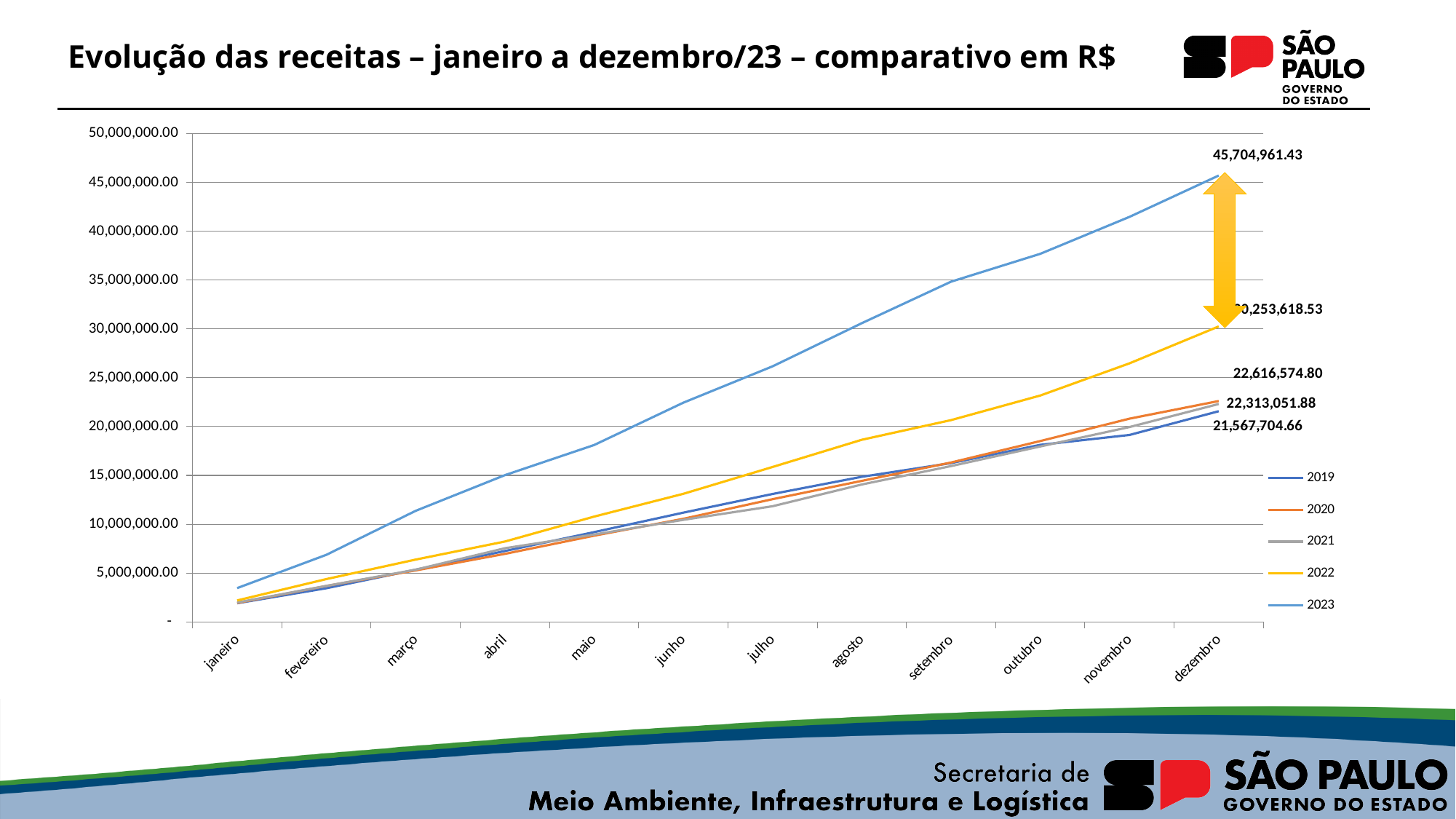
Which is larger in dezembro, the value for 2023 or the value for 2022? 2023 What is the value for 2019 in dezembro? 21,567,704.66 What is the difference between the dezembro values for 2023 and 2019? 24,137,256.77 Is the value for 2023 in junho greater or less than 20,000,000.00? greater Which year has the highest value in dezembro? 2023 Is the value for 2022 in junho greater or less than 15,000,000.00? less How many series does the legend list? 5 What kind of chart is shown on the slide? line chart How many months are shown along the x axis? 12 What is the value for 2023 in dezembro? 45,704,961.43 Do the values for 2023 rise or fall from janeiro to dezembro? rise Which year has the lowest value in dezembro? 2019